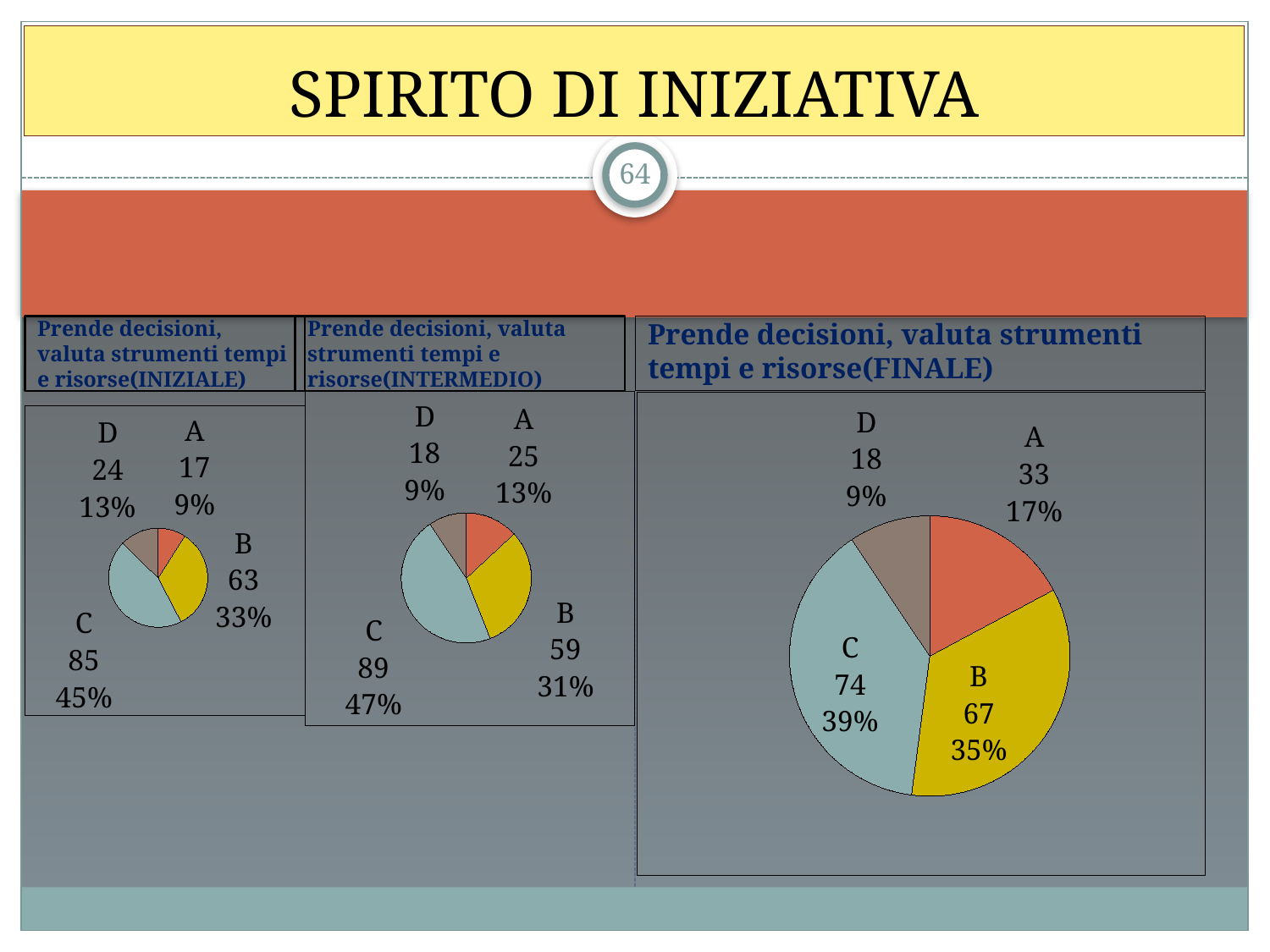
In the INTERMEDIO chart, what is the value for A? 25 What kind of chart is used in the INIZIALE chart? pie chart How many categories are shown in the FINALE chart? 4 In the INTERMEDIO chart, which category has the highest value? C In the INIZIALE chart, which category has the lowest value? A In the FINALE chart, which is larger, the value for A or the value for D? A In the INIZIALE chart, what share of the pie does B represent? 33% In the FINALE chart, what share of the pie does C represent? 39% In the FINALE chart, what is the value for B? 67 In the INTERMEDIO chart, what is the difference between the values for C and B? 30 In the INIZIALE chart, what is the value for C? 85 In the FINALE chart, what is the difference between the values for C and A? 41